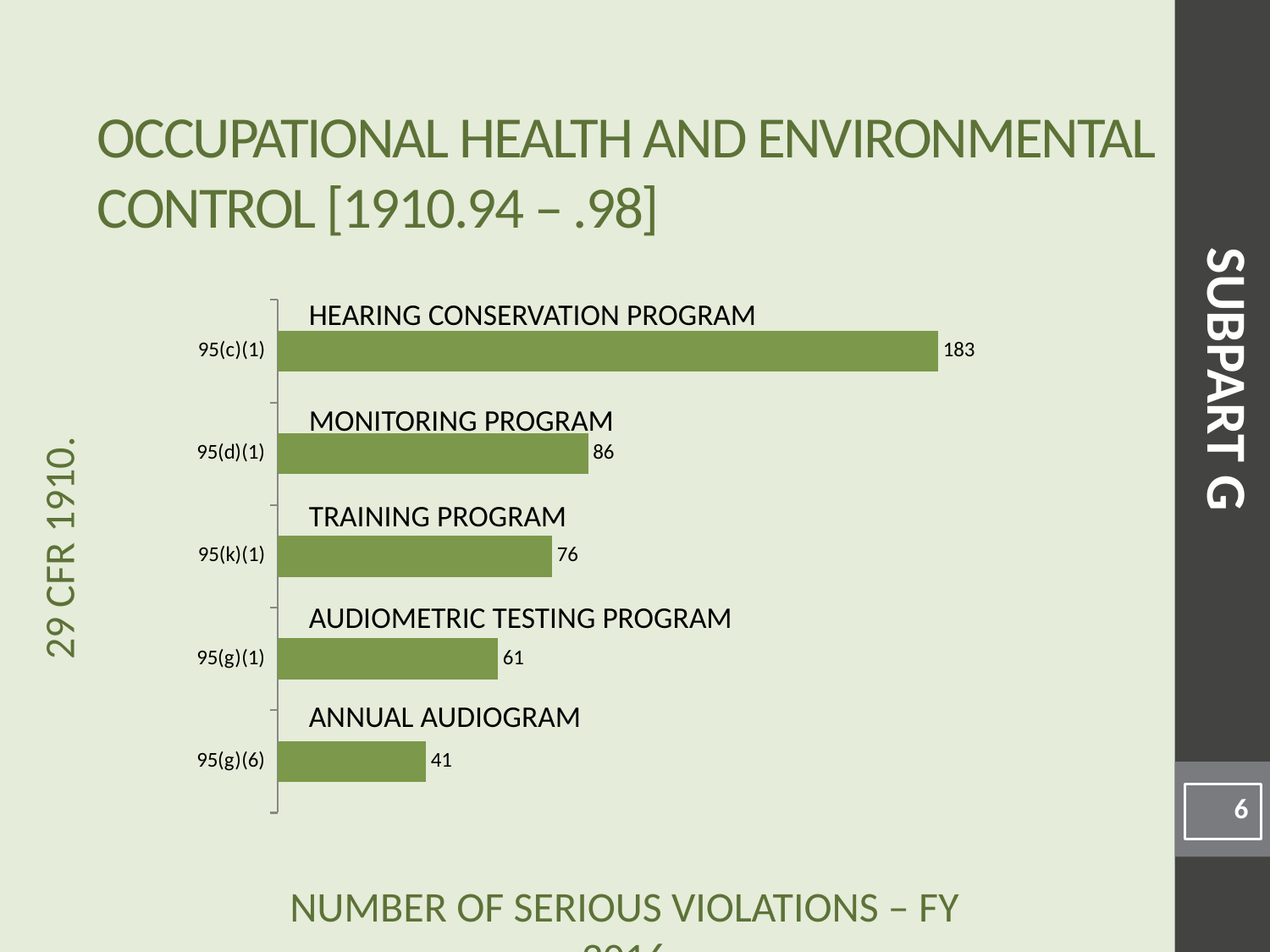
What is the difference between the values for 95(c)(1) and 95(d)(1)? 97 Which has a larger value, 95(d)(1) or 95(k)(1)? 95(d)(1) What is the difference between the values for 95(k)(1) and 95(g)(1)? 15 How many categories are shown in the chart? 5 What kind of chart is shown on the slide? Bar chart What is the value shown for 95(d)(1), the Monitoring Program? 86 What is the number of serious violations for 95(c)(1), the Hearing Conservation Program? 183 Which category has the lowest number of serious violations? 95(g)(6) What is the value shown for 95(g)(1), the Audiometric Testing Program? 61 What is the value shown for 95(g)(6), Annual Audiogram? 41 What colour are the bars in the chart? Green Which category has the highest number of serious violations? 95(c)(1)